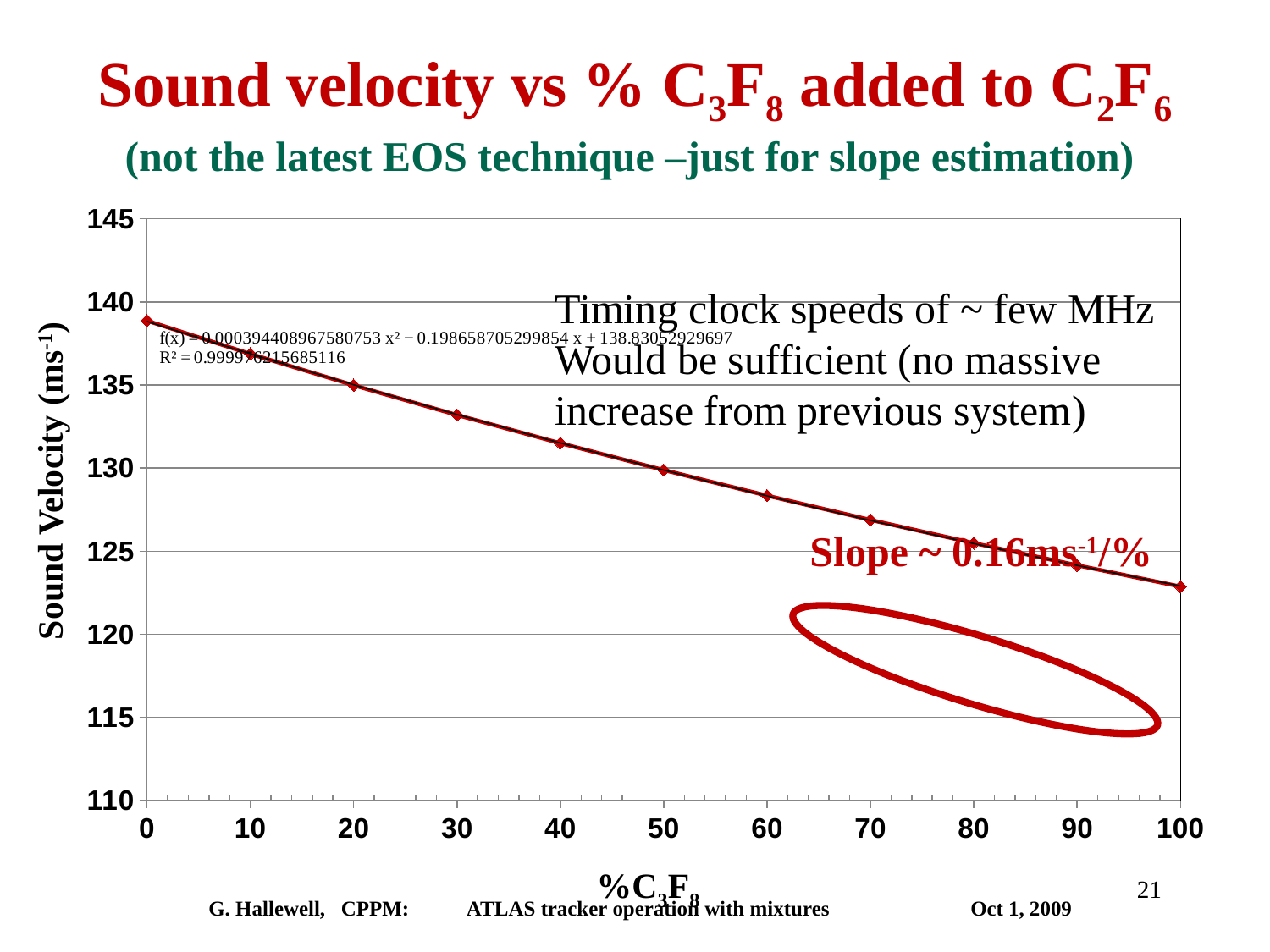
Is the sound velocity at 0% C3F8 greater or less than 135? greater At which % C3F8 value is the sound velocity lowest? 100 At which % C3F8 value is the sound velocity highest? 0 Is the sound velocity at 100% C3F8 greater or less than 125? less Which has the larger sound velocity, 20% C3F8 or 60% C3F8? 20% C3F8 What is the label on the y axis of the chart? Sound Velocity (ms-1) Is the sound velocity at 70% C3F8 greater or less than 130? less What is the title of the chart on the slide? Sound velocity vs % C3F8 added to C2F6 What kind of chart is shown on the slide? line chart Does the sound velocity rise or fall as the % C3F8 increases along the x axis? fall How many data points are plotted on the chart? 11